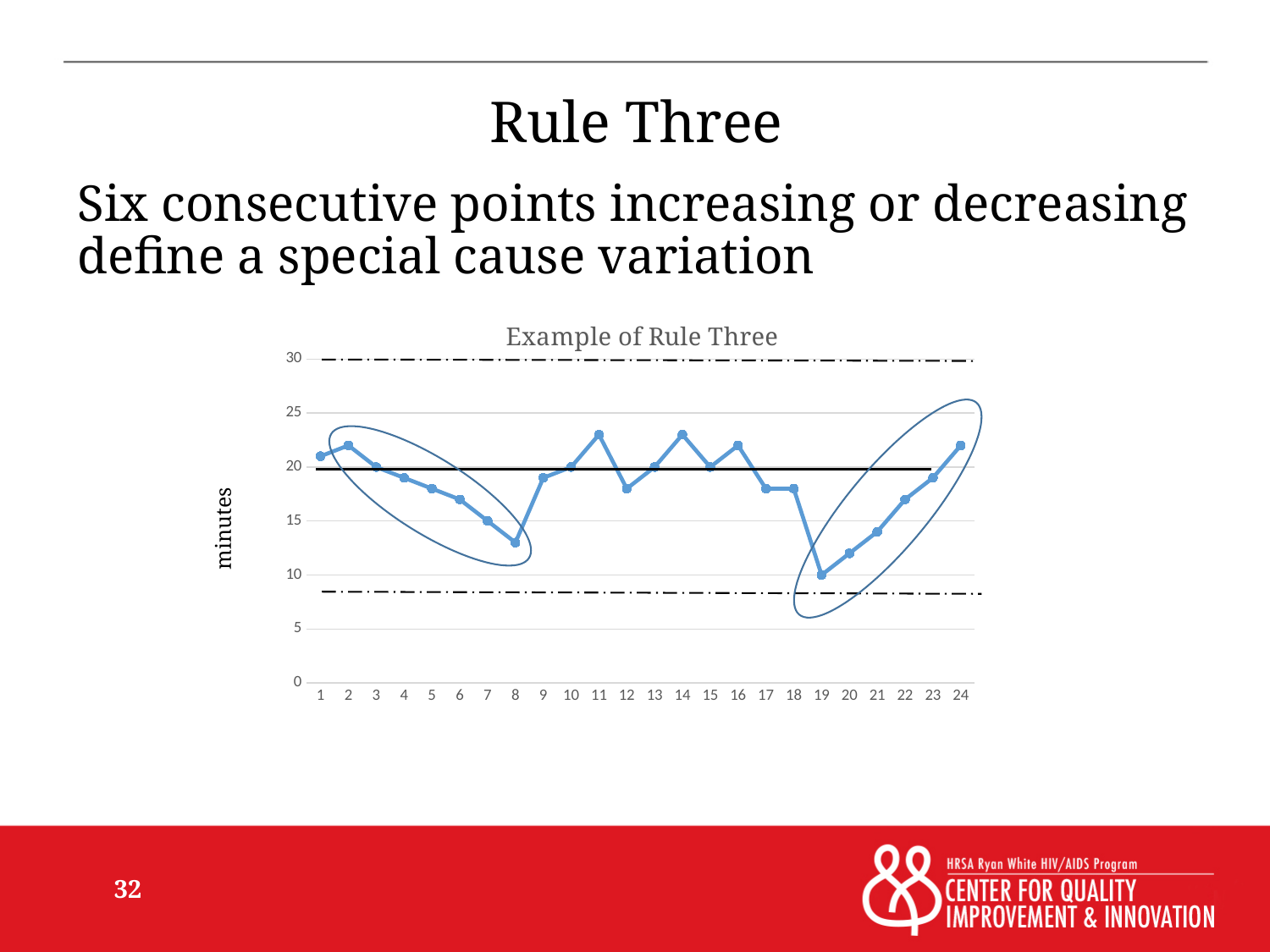
What is the value at point 19? 10 How many data points are plotted on the chart? 24 Which has the larger value, point 11 or point 12? point 11 Is the value at point 8 greater or less than 15? less Which point on the x axis has the lowest value? 19 What is the label on the vertical axis of the chart? minutes Is the value at point 11 greater or less than 20? greater Do the values rise or fall from point 19 to point 24? rise Do the values rise or fall from point 3 to point 8? fall Is the value at point 24 greater or less than 20? greater What type of chart is shown on the slide? line chart What is the title of the chart? Example of Rule Three